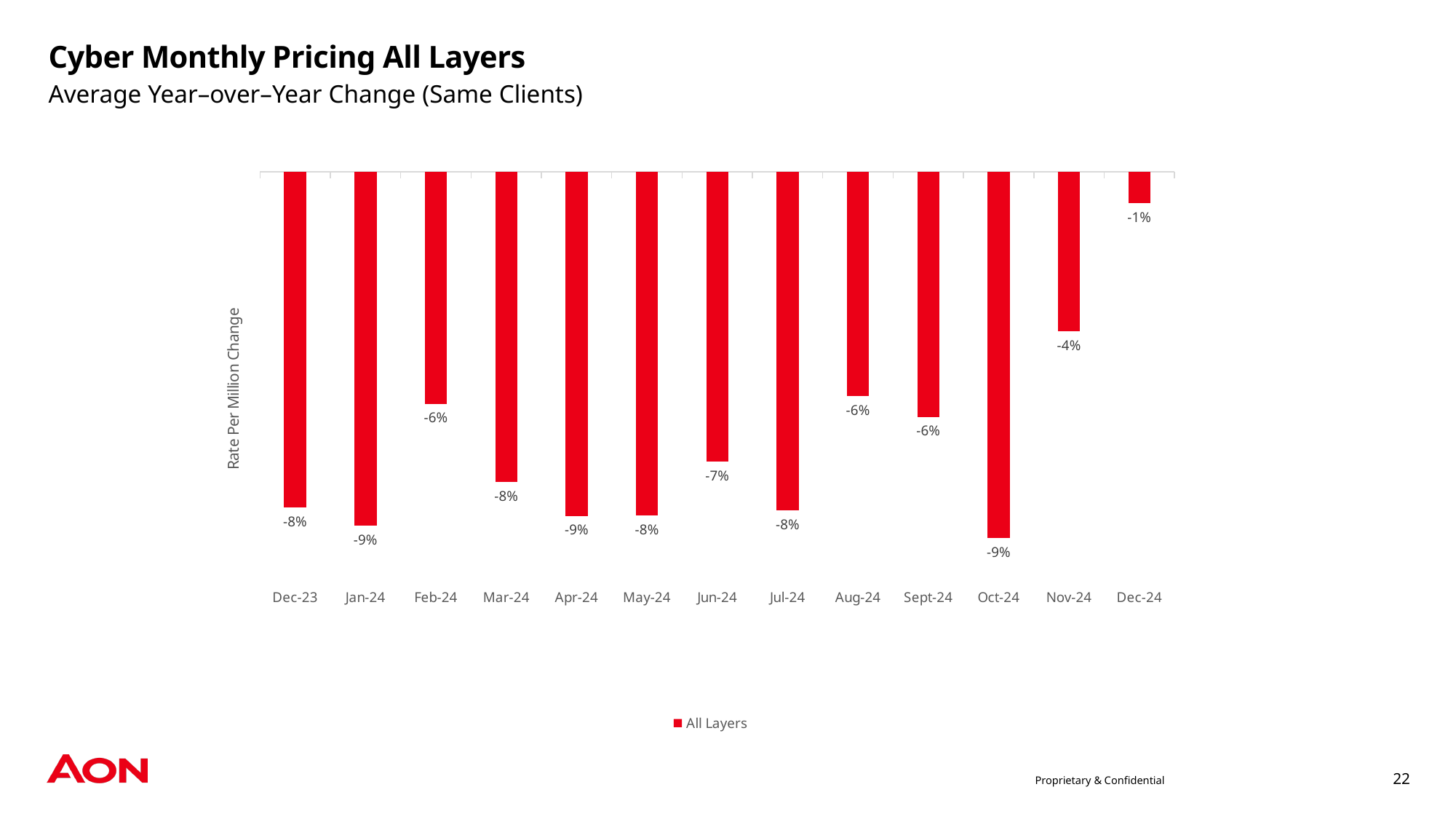
What is the value for Oct-24? -9% What is the value for Nov-24? -4% How many months are shown on the x axis? 13 What is the label on the vertical axis? Rate Per Million Change What kind of chart is shown on the slide? Bar chart What is the value for Jun-24? -7% What is the difference in percentage points between the values for Nov-24 and Dec-24? 3 percentage points How many series does the legend list? 1 Which month shows the smallest year-over-year decline? Dec-24 What is the value for Dec-24? -1% What is the value for Feb-24? -6% Which month shows the larger decline, Nov-24 or Dec-24? Nov-24